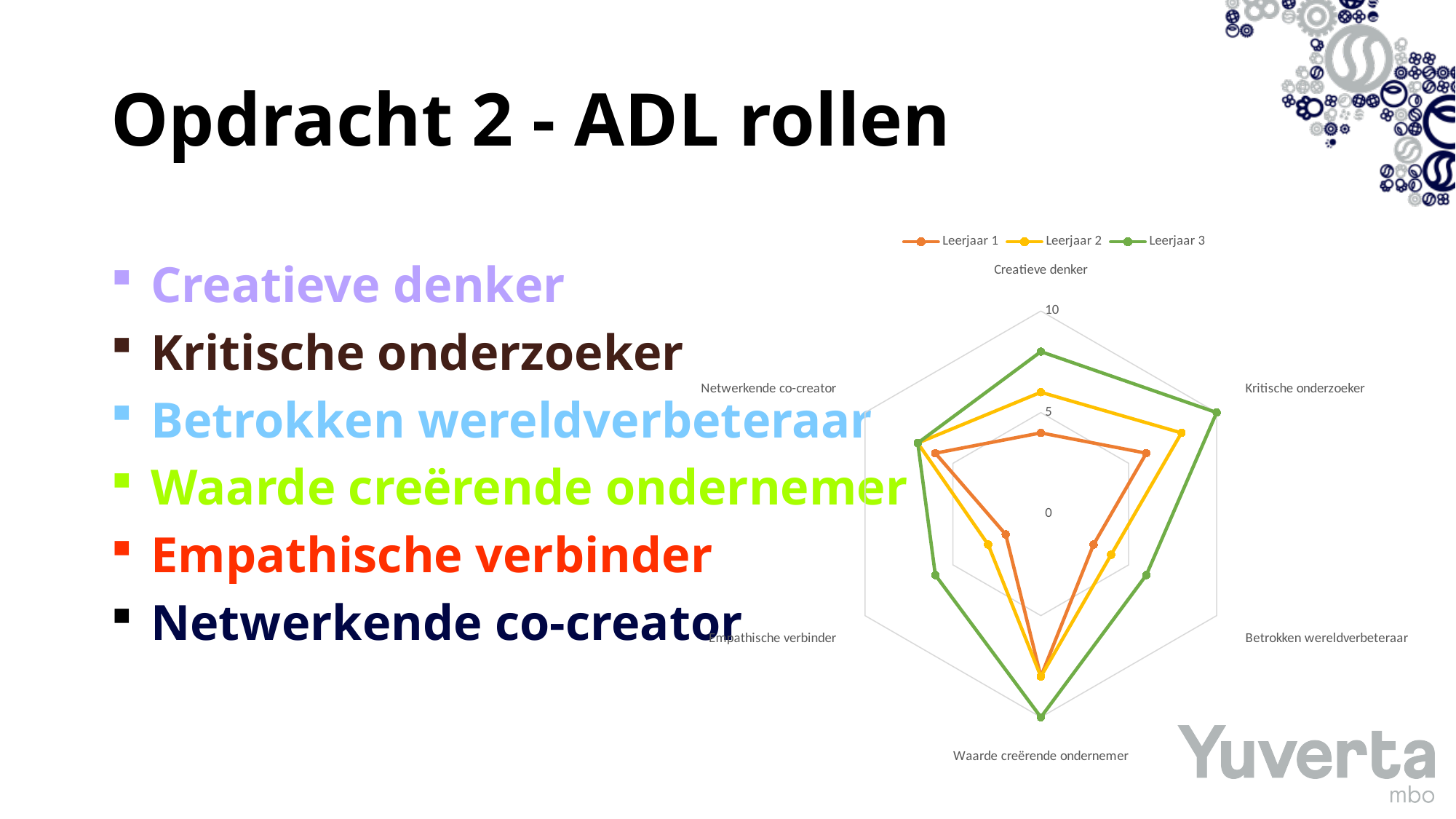
Which series is drawn in green in the chart? Leerjaar 3 Is the value for Empathische verbinder in Leerjaar 1 greater or less than 5? less How many series does the chart legend list? 3 Is the value for Creatieve denker in Leerjaar 3 greater or less than 5? greater What kind of chart is shown on the slide? Radar chart For Leerjaar 1, which category has the lowest value? Empathische verbinder Is the value for Kritische onderzoeker in Leerjaar 3 greater or less than 5? greater For Leerjaar 1, which category has the highest value? Waarde creërende ondernemer For Creatieve denker, which is larger: the value for Leerjaar 1 or for Leerjaar 3? Leerjaar 3 How many categories (axes) does the radar chart have? 6